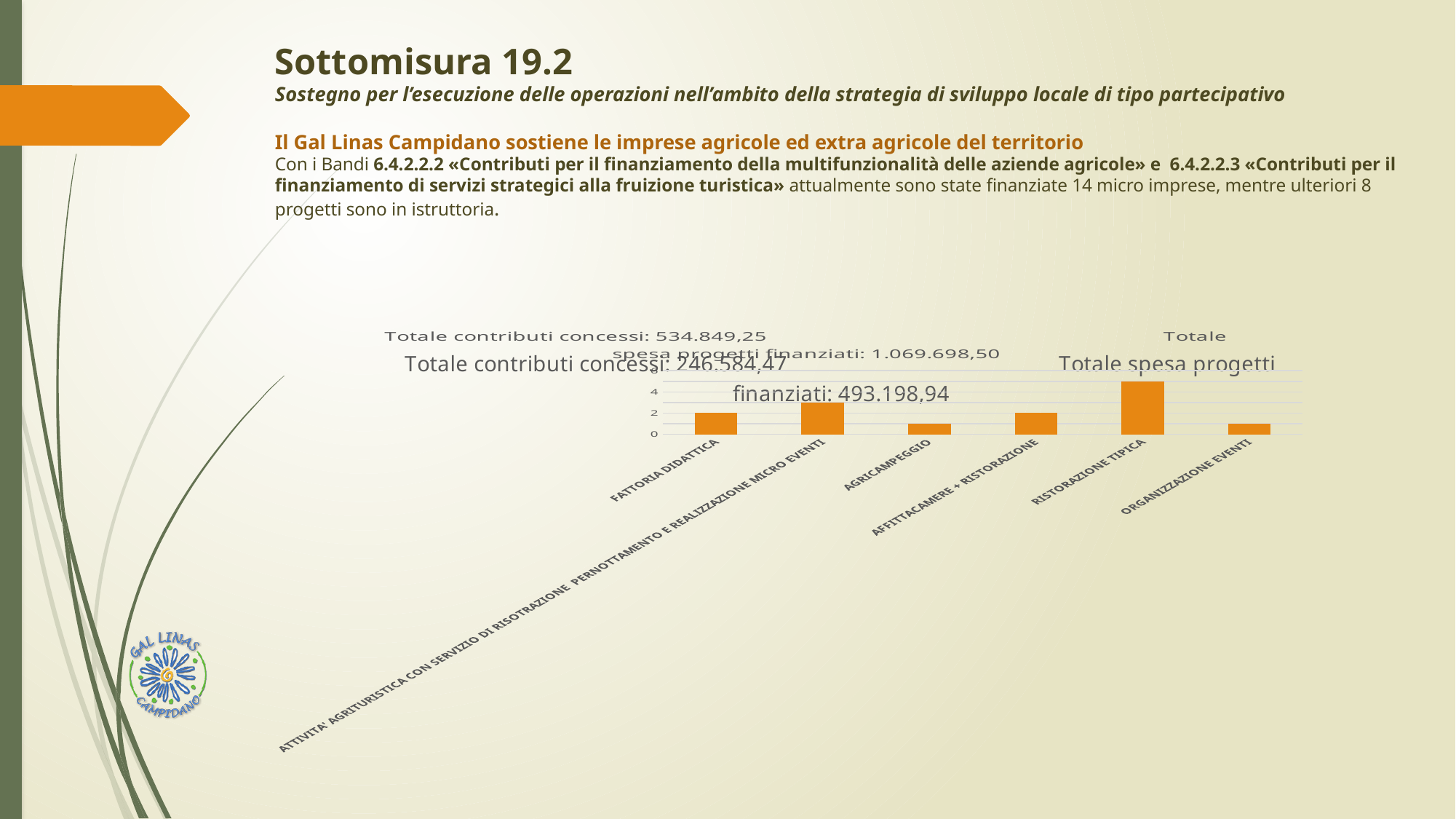
Is the value for AGRICAMPEGGIO greater or less than 2? less What is the value for FATTORIA DIDATTICA in the chart? 2 Is the value for ATTIVITA' AGRITURISTICA CON SERVIZIO DI RISTORAZIONE PERNOTTAMENTO E REALIZZAZIONE MICRO EVENTI greater or less than 2? greater Which category has the highest bar in the chart? RISTORAZIONE TIPICA What colour are the bars in the chart? orange How many categories are shown on the x axis of the chart? 6 Which is larger, the value for RISTORAZIONE TIPICA or the value for FATTORIA DIDATTICA? RISTORAZIONE TIPICA Is the value for RISTORAZIONE TIPICA greater or less than 4? greater Which is larger, the value for ATTIVITA' AGRITURISTICA CON SERVIZIO DI RISTORAZIONE PERNOTTAMENTO E REALIZZAZIONE MICRO EVENTI or the value for AGRICAMPEGGIO? ATTIVITA' AGRITURISTICA CON SERVIZIO DI RISTORAZIONE PERNOTTAMENTO E REALIZZAZIONE MICRO EVENTI What total of contributions granted (Totale contributi concessi) is printed in the chart's title area? 534.849,25 What kind of chart is shown on the slide? bar chart